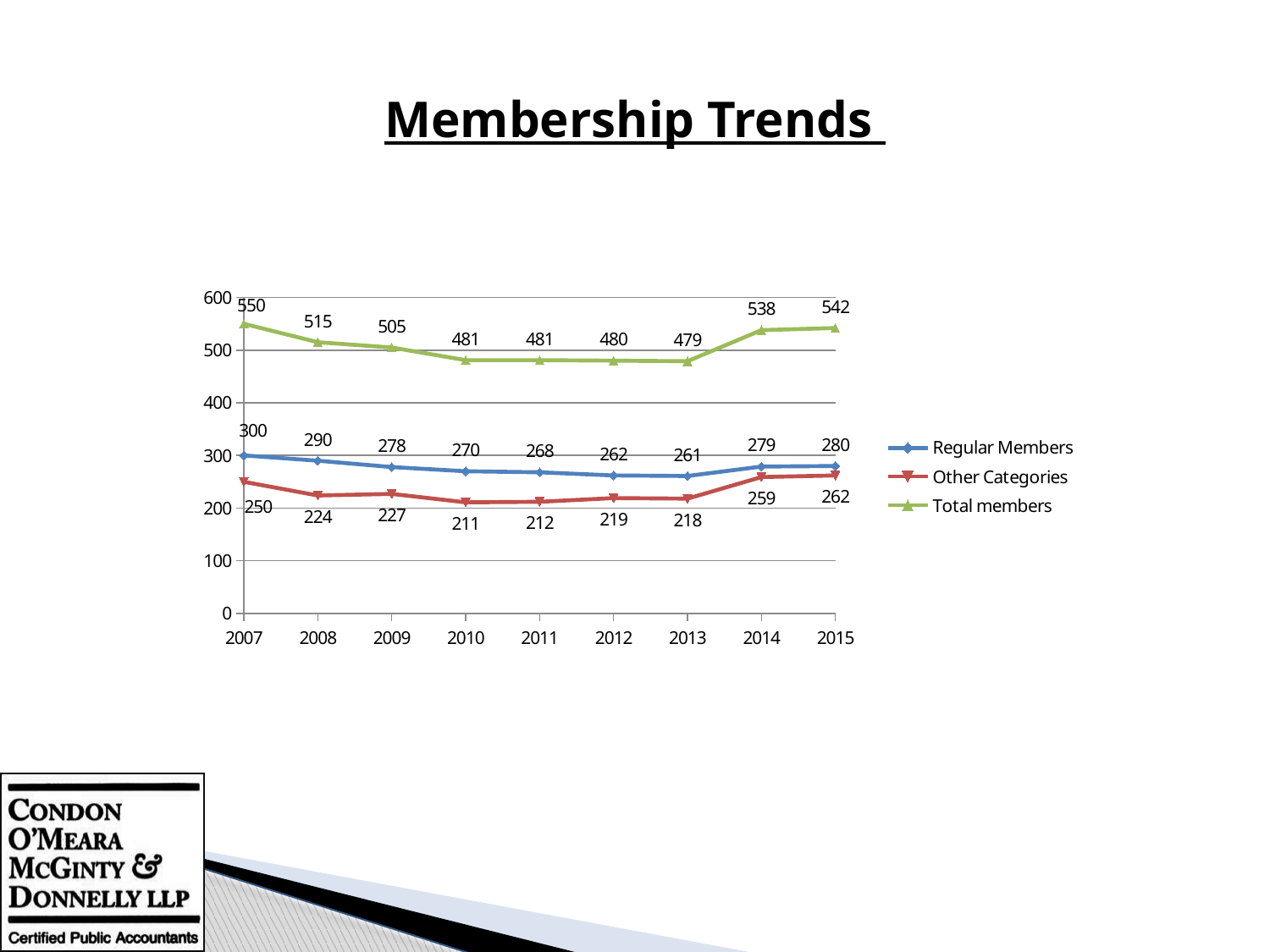
What kind of chart is shown on the slide? line chart Does Total members rise or fall from 2007 to 2010? fall How many years are plotted along the x axis? 9 What is the value for Other Categories in 2010? 211 What is the value for Regular Members in 2013? 261 In which year is Total members lowest? 2013 What is the difference between Total members in 2015 and in 2007? 8 How many series does the legend list? 3 In which year is Regular Members highest? 2007 Which is larger, Other Categories in 2014 or Other Categories in 2008? 2014 What is the title of the chart? Membership Trends What is the value for Total members in 2007? 550